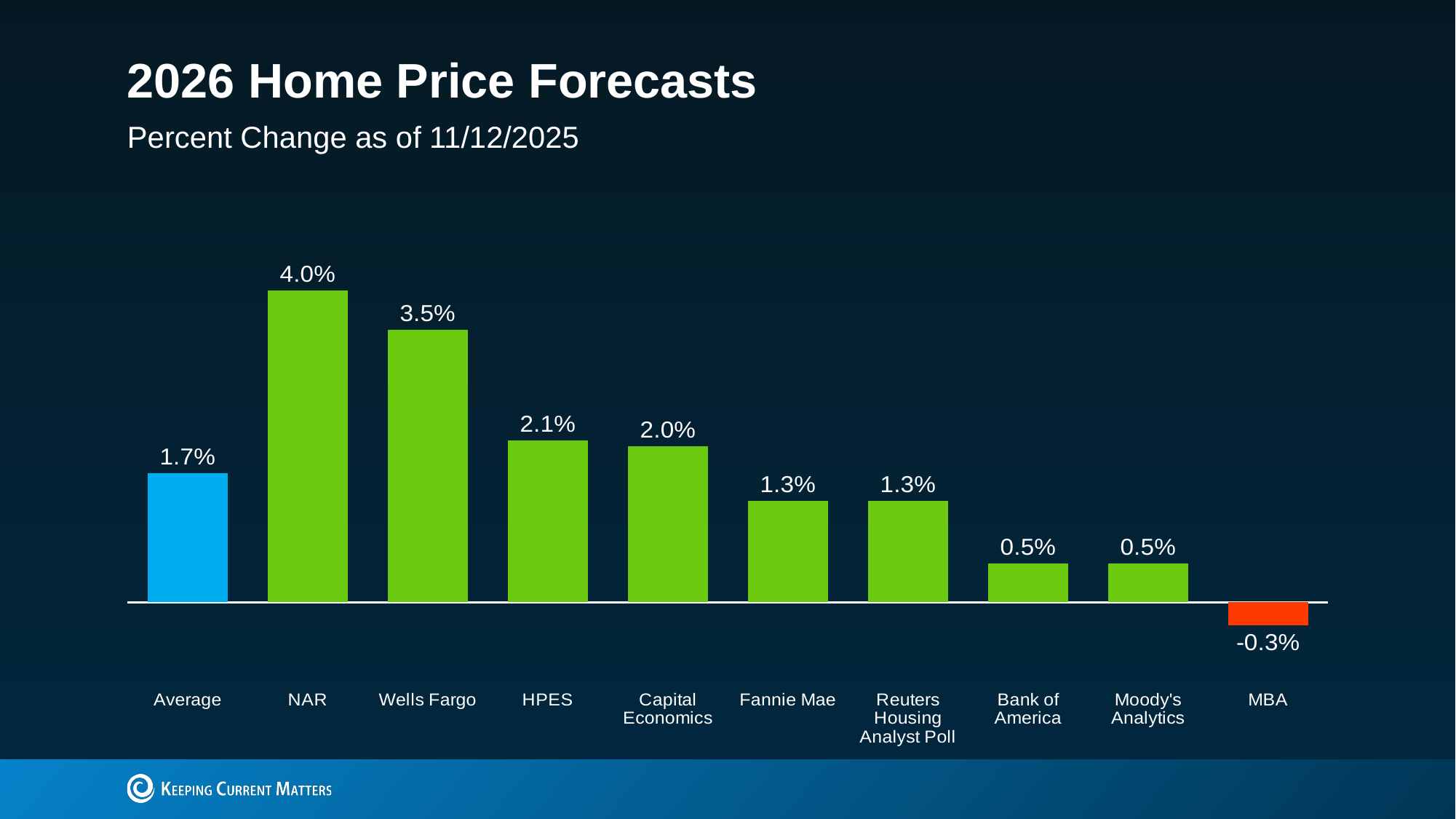
How many bars are shown on the chart? 10 Which forecaster has the highest 2026 home price forecast? NAR What kind of chart is shown on the slide? Bar chart What is the forecast value for NAR? 4.0% Which forecaster has the lowest 2026 home price forecast? MBA What is the difference between the HPES forecast and the Fannie Mae forecast? 0.8% What is the forecast value for Wells Fargo? 3.5% What is the forecast value for MBA? -0.3% What is the value shown for Average? 1.7% Which is larger, the forecast for Capital Economics or the forecast for Bank of America? Capital Economics What is the title of the chart? 2026 Home Price Forecasts What is the difference between the NAR forecast and the Wells Fargo forecast? 0.5%